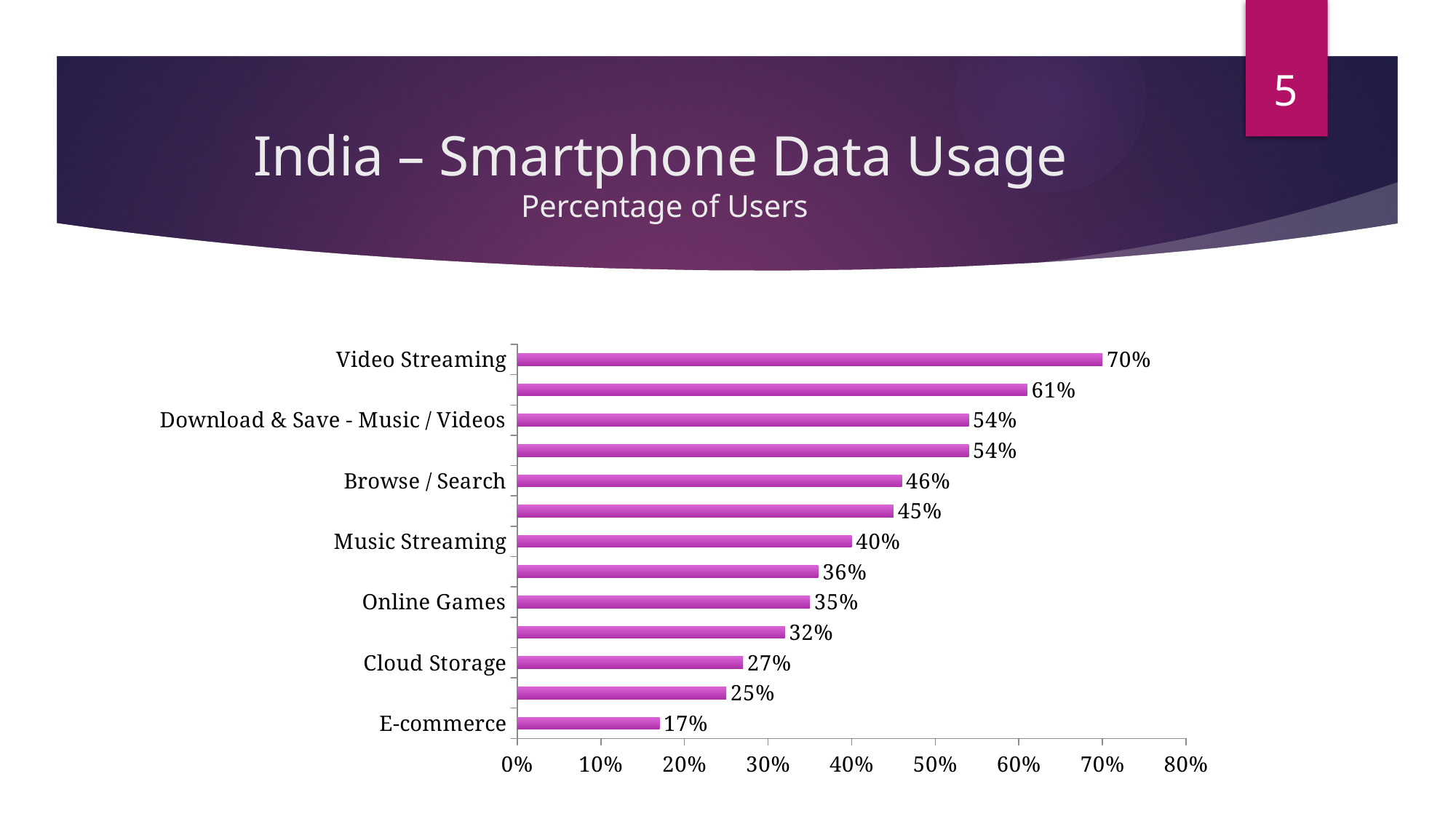
What is the value for Music Streaming? 40% Which category has the highest value? Video Streaming Which category has the lowest value? E-commerce Which is larger, the value for Browse / Search or the value for Online Games? Browse / Search What is the value for E-commerce? 17% What is the difference between the values for Video Streaming and E-commerce? 53% What is the value for Video Streaming? 70% What kind of chart is shown on the slide? Bar chart How many bars are plotted in the chart? 13 Do the bars get longer or shorter going from the top of the chart to the bottom? Shorter What is the value for Cloud Storage? 27% What is the difference between the values for Download & Save - Music / Videos and Music Streaming? 14%